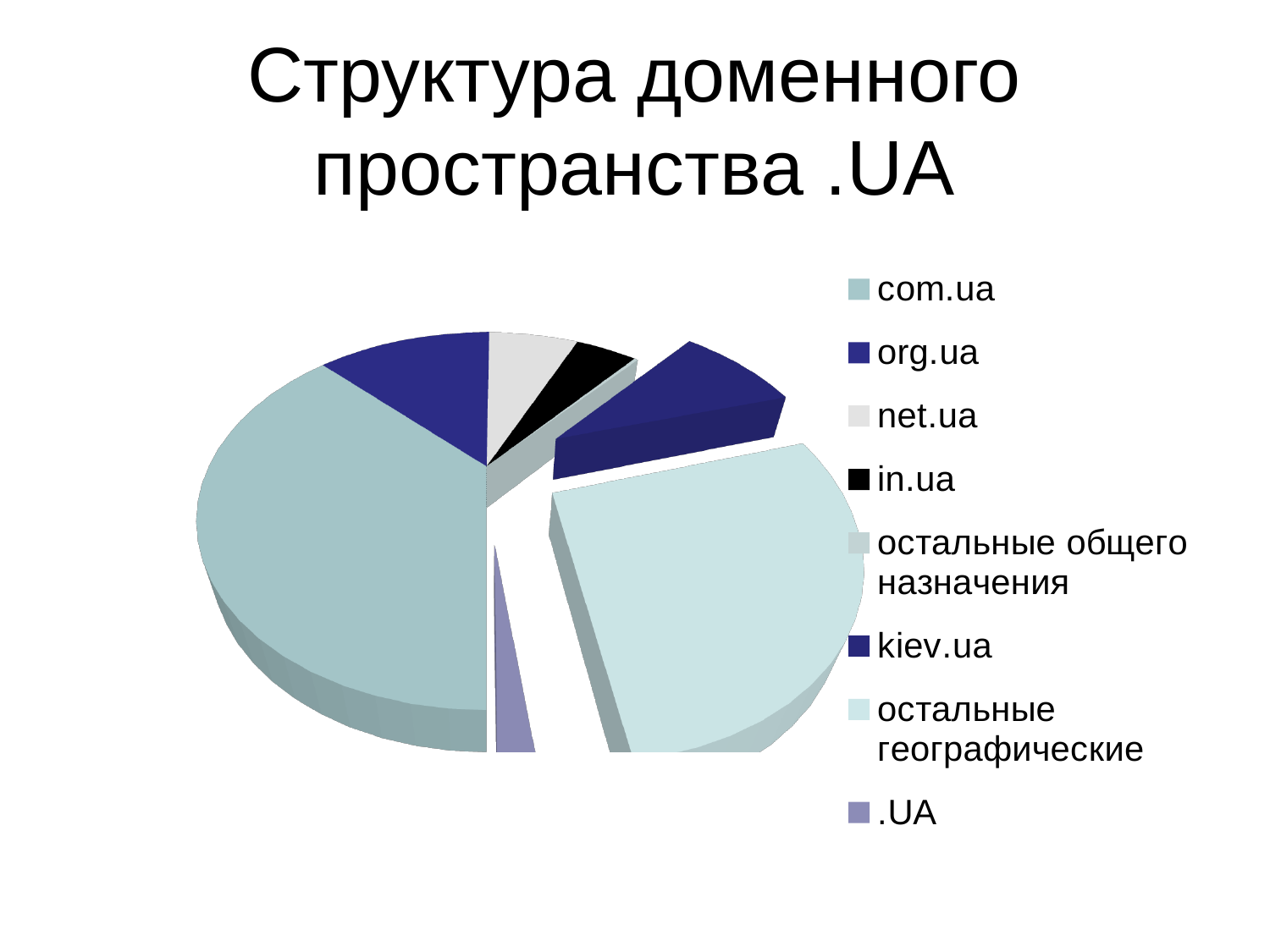
How many categories (slices) does the pie chart have? 8 Which slice is larger, com.ua or .UA? com.ua What kind of chart is shown on the slide? pie chart What colour is the in.ua slice in the legend? black Which slice is larger, org.ua or net.ua? org.ua Which slice is larger, остальные географические or org.ua? остальные географические Which category has the largest slice of the pie? com.ua What is the title of the chart on the slide? Структура доменного пространства .UA